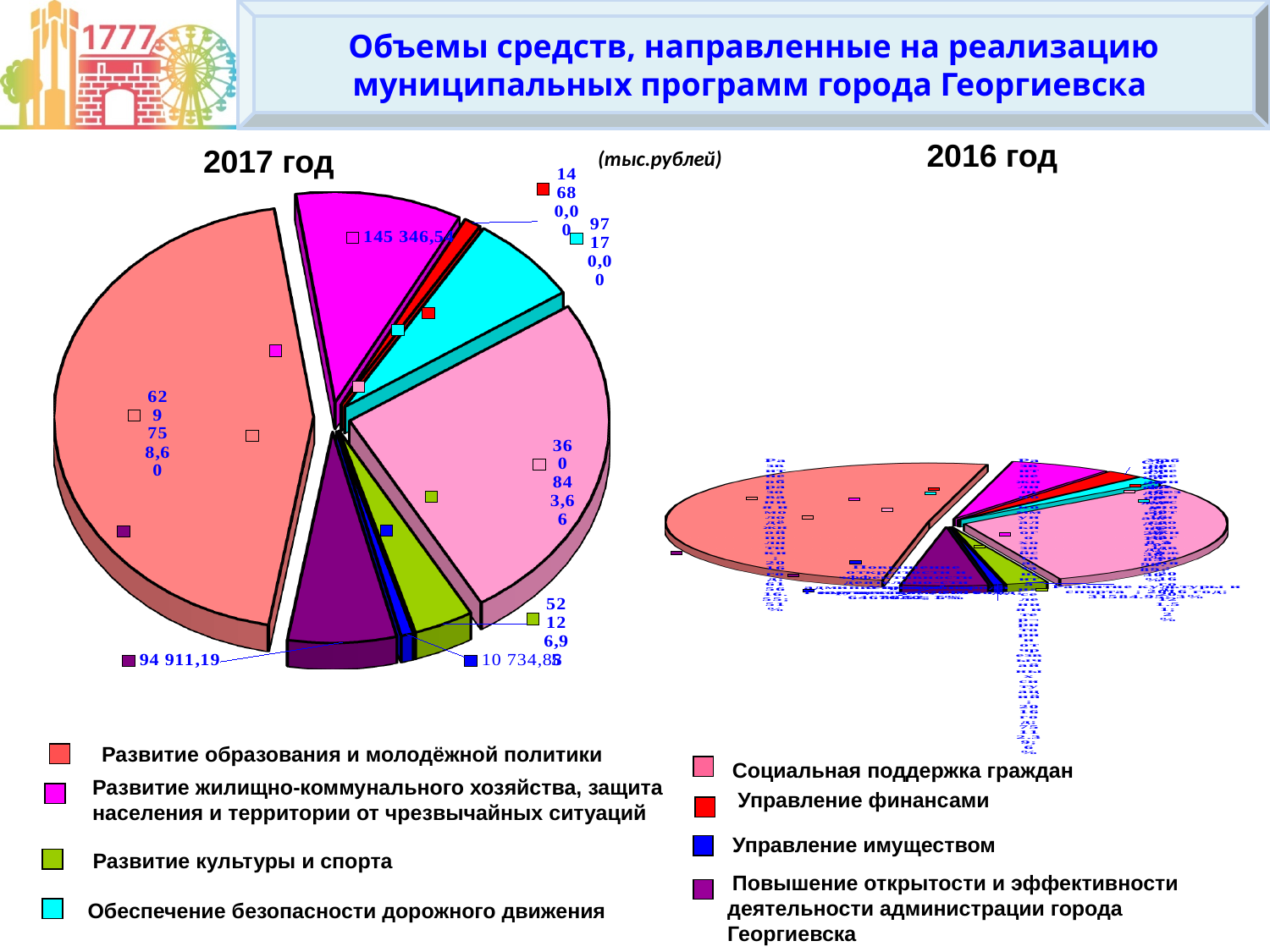
What kind of chart is used for the 2017 год data? pie chart In the 2017 год chart, what is the value for Социальная поддержка граждан? 360 843,66 How many programme categories does the legend list? 8 In the 2017 год chart, which programme has the largest slice? Развитие образования и молодёжной политики In the 2017 год chart, what is the value for Обеспечение безопасности дорожного движения? 97 170,00 In the 2017 год chart, what is the value for Повышение открытости и эффективности деятельности администрации города Георгиевска? 94 911,19 In the 2017 год chart, what is the value for Управление финансами? 14 680,00 In the 2017 год chart, which is larger: Развитие жилищно-коммунального хозяйства or Обеспечение безопасности дорожного движения? Развитие жилищно-коммунального хозяйства In the 2017 год chart, what is the value for Развитие образования и молодёжной политики? 629 758,60 In what units are the values on the slide given? тыс.рублей In the 2017 год chart, what is the difference between Развитие образования и молодёжной политики and Социальная поддержка граждан? 268 914,94 In the 2017 год chart, which is larger: Развитие образования и молодёжной политики or Социальная поддержка граждан? Развитие образования и молодёжной политики